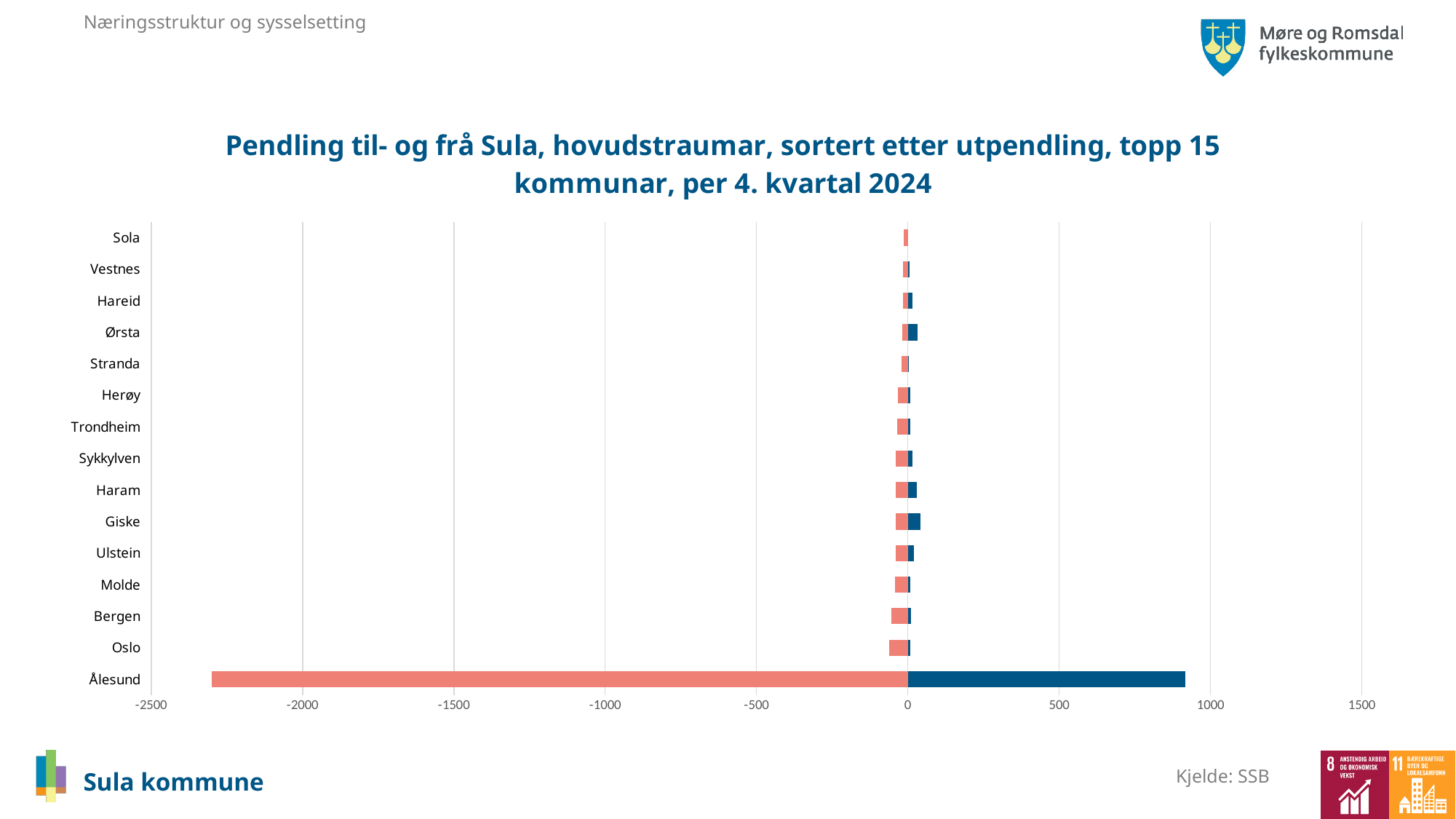
Which has the larger negative (red) bar, Ålesund or Oslo? Ålesund Is the negative (red) value for Ålesund greater or less than -2000? less Which municipality has the largest negative (red) bar in the chart? Ålesund Is the positive (blue) value for Ålesund greater or less than 1000? less What kind of chart is shown on the slide? bar chart Is the positive (blue) value for Ålesund greater or less than 500? greater How many municipalities (categories) are listed on the vertical axis of the chart? 15 Which has the larger positive (blue) bar, Ålesund or Giske? Ålesund What is the title of the chart? Pendling til- og frå Sula, hovudstraumar, sortert etter utpendling, topp 15 kommunar, per 4. kvartal 2024 Which municipality has the longest bar in the chart? Ålesund What is the lowest value shown on the horizontal axis of the chart? -2500